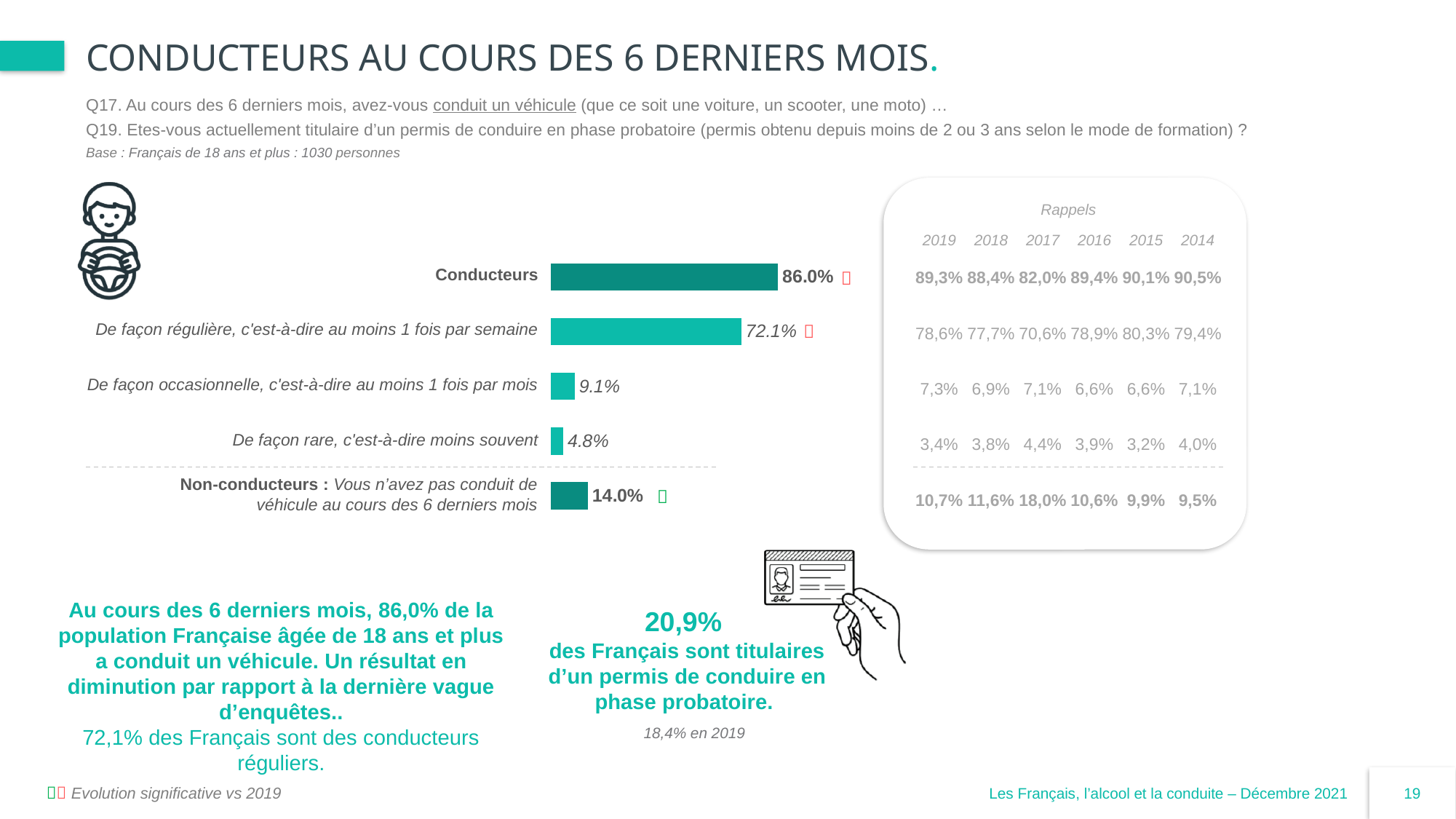
Which category has the highest value in the bar chart? Conducteurs What is the value for "De façon régulière, c'est-à-dire au moins 1 fois par semaine"? 72.1% In the "Rappels" table, what was the value for "Conducteurs" in 2019? 89,3% What is the value for "De façon rare, c'est-à-dire moins souvent"? 4.8% What kind of chart is shown on the slide? Bar chart What is the difference between the values for "Conducteurs" and "Non-conducteurs"? 72.0% What is the value for "De façon occasionnelle, c'est-à-dire au moins 1 fois par mois"? 9.1% What is the value for "Non-conducteurs"? 14.0% How many bars are shown in the bar chart? 5 What is the value for "Conducteurs" in the bar chart? 86.0% Which category has the lowest value in the bar chart? De façon rare, c'est-à-dire moins souvent Which is larger: the value for "De façon occasionnelle" or the value for "De façon rare"? De façon occasionnelle